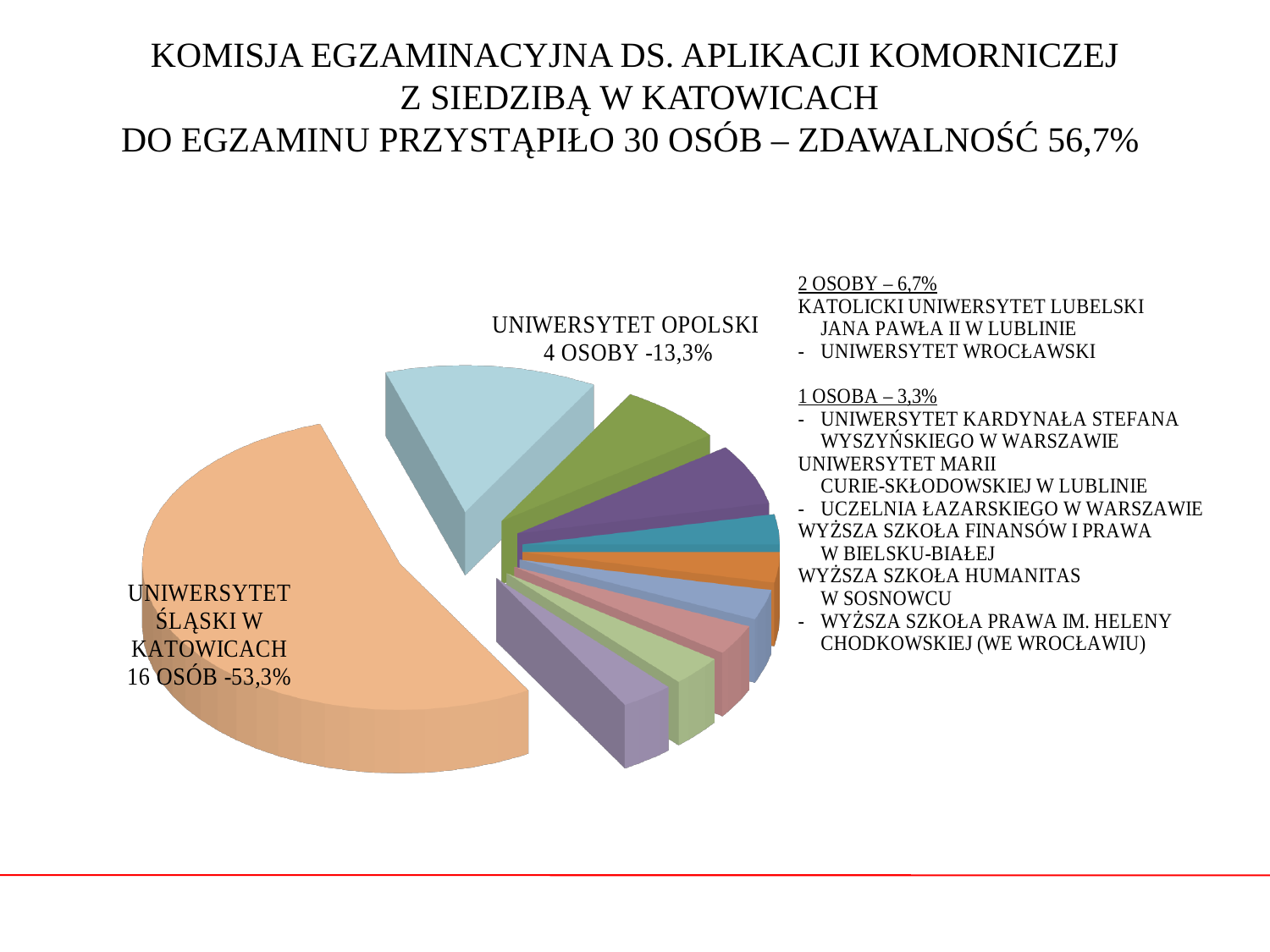
How many people from Uniwersytet Opolski are shown on the chart? 4 osoby What kind of chart is shown on the slide? Pie chart Which is larger: the number of people from Uniwersytet Śląski w Katowicach or from Uniwersytet Opolski? Uniwersytet Śląski w Katowicach Which university has the largest slice of the pie? Uniwersytet Śląski w Katowicach What pass rate (zdawalność) is given in the slide title? 56,7% What percentage share is shown for Uniwersytet Opolski? 13,3% What share of the pie does Uniwersytet Śląski w Katowicach represent? 53,3% What is the difference between the number of people from Uniwersytet Śląski w Katowicach and from Uniwersytet Opolski? 12 What share of the pie does Uczelnia Łazarskiego w Warszawie represent? 3,3% How many people from Uniwersytet Wrocławski are shown, and what share is that? 2 osoby – 6,7% How many people from Uniwersytet Śląski w Katowicach took the exam according to the chart? 16 osób How many people in total took the exam according to the slide title? 30 osób